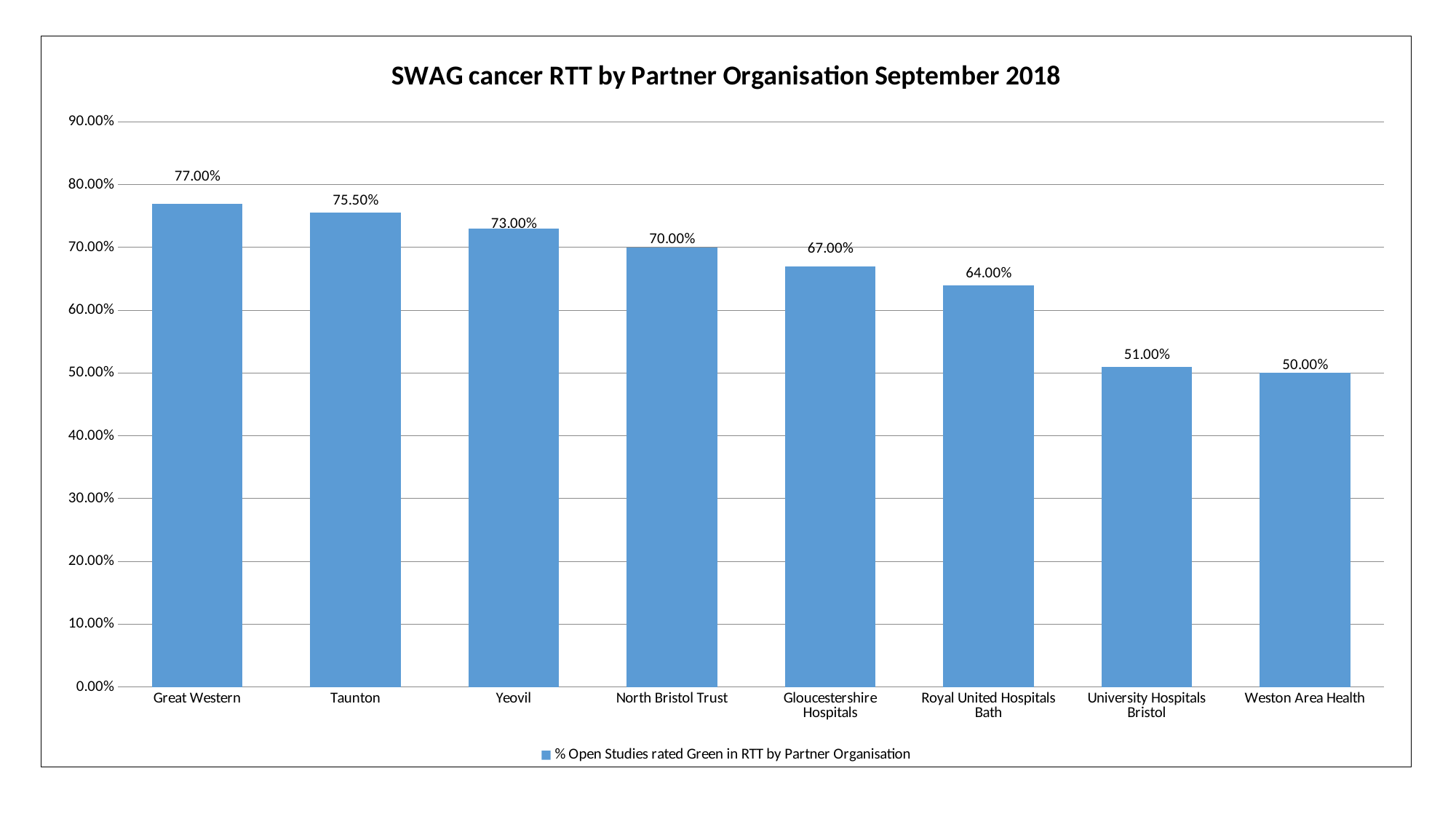
What kind of chart is shown on the slide? Bar chart How many partner organisations are shown on the chart? 8 What is the difference between the values for Taunton and Yeovil? 2.50% What is the value for Great Western? 77.00% What is the difference between the values for North Bristol Trust and Royal United Hospitals Bath? 6.00% What is the value for Gloucestershire Hospitals? 67.00% Which partner organisation has the highest value? Great Western What is the value for University Hospitals Bristol? 51.00% Which is larger, the value for Yeovil or the value for Royal United Hospitals Bath? Yeovil Which partner organisation has the lowest value? Weston Area Health How many series does the legend list? 1 Do the values rise or fall from left to right along the x axis? Fall